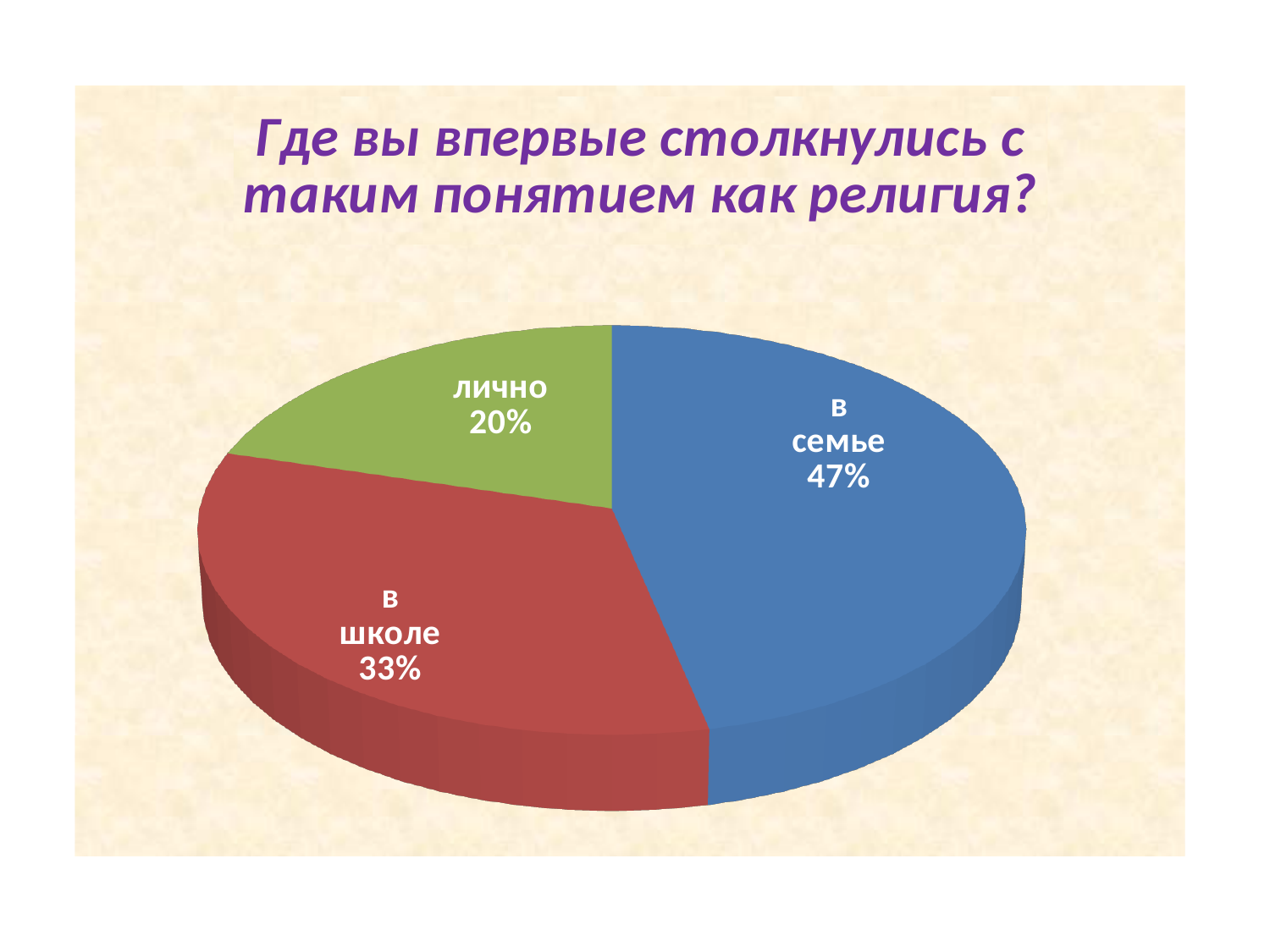
What kind of chart is shown on the slide? pie chart What share of the pie does the "лично" slice represent? 20% What is the difference in percentage points between the "в школе" and "лично" slices? 13 Which category has the largest slice of the pie? в семье How many slices does the pie chart have? 3 Which category has the smallest slice of the pie? лично What share of the pie does the "в школе" slice represent? 33% Which is larger, the "в школе" slice or the "лично" slice? в школе What colour is the "в семье" slice? blue What is the difference in percentage points between the "в семье" and "в школе" slices? 14 What share of the pie does the "в семье" slice represent? 47% What is the title of the chart on the slide? Где вы впервые столкнулись с таким понятием как религия?